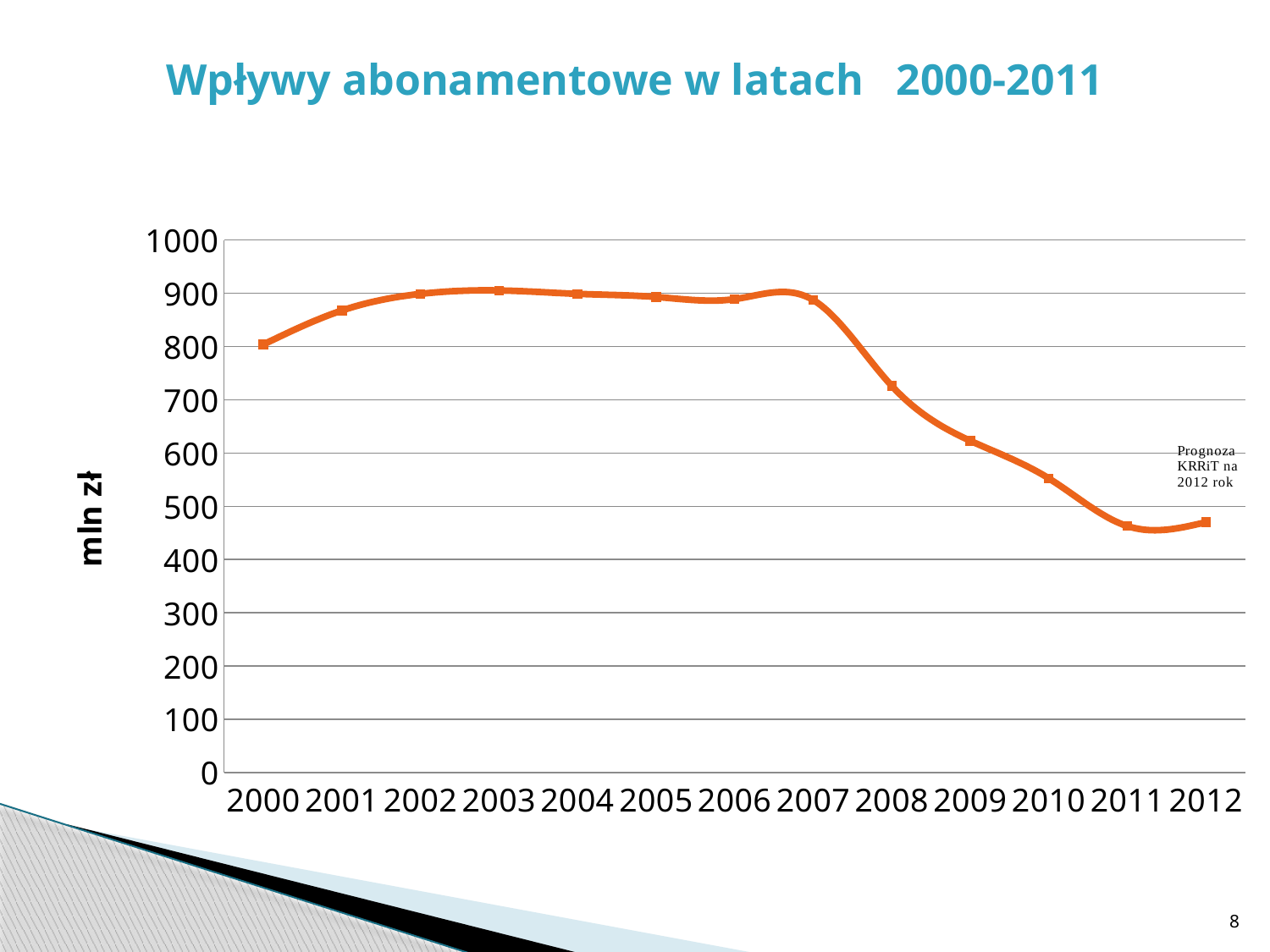
Is the value for 2010 greater or less than 500? greater Which year has the larger value, 2007 or 2008? 2007 Is the value for 2009 greater or less than 600? greater Is the value for 2011 greater or less than 500? less Do the values rise or fall from 2007 to 2011? fall What kind of chart is shown on the slide? line chart What is the label on the vertical axis of the chart? mln zł How many years (data points) are plotted on the chart? 13 What is the title of the chart on the slide? Wpływy abonamentowe w latach 2000-2011 Which year has the larger value, 2000 or 2003? 2003